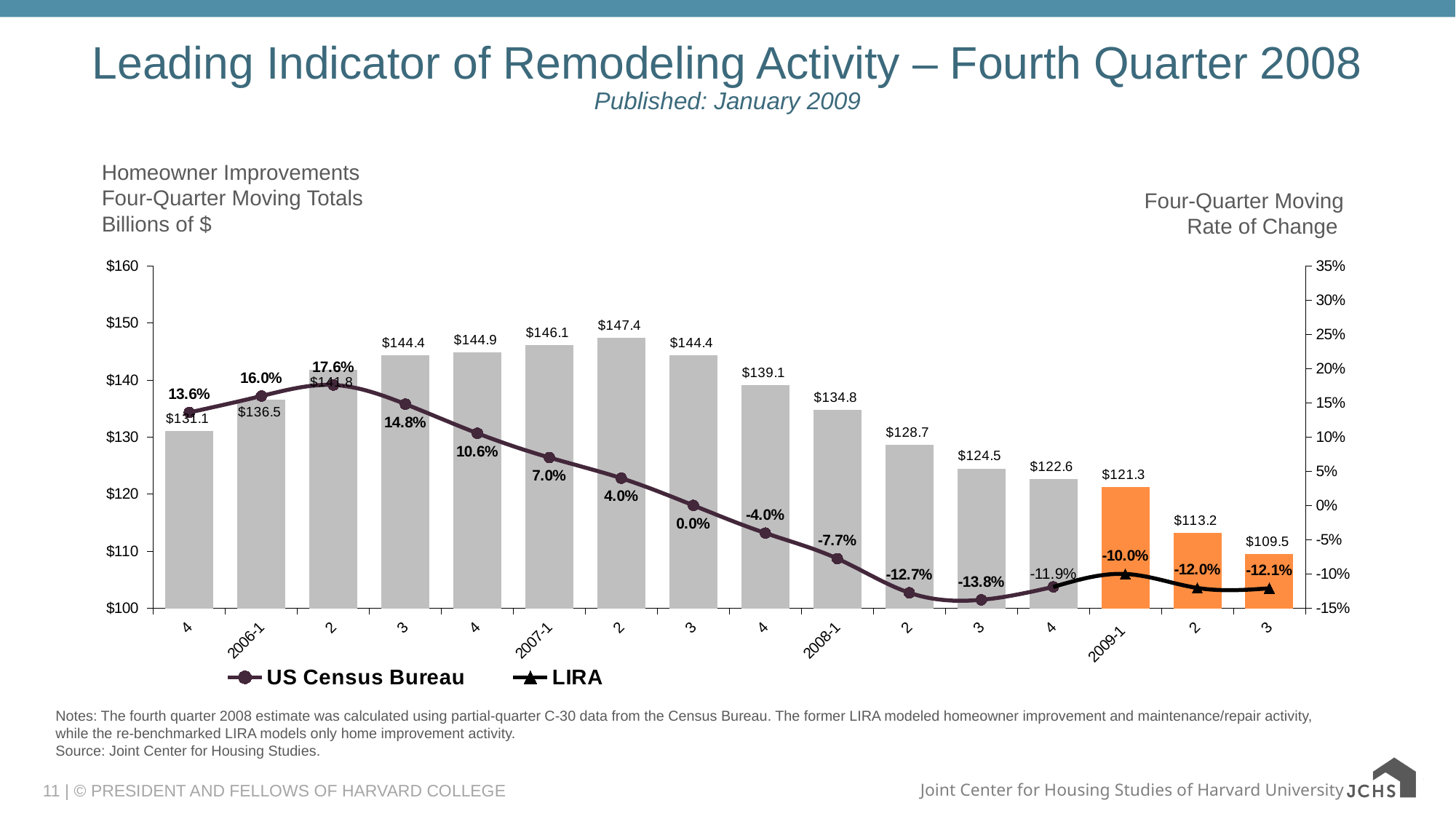
Which is larger, the four-quarter moving total for 2006-3 or for 2008-1? 2006-3 Which quarter has the lowest four-quarter moving rate of change? 2008-3 What are the two series named in the legend? US Census Bureau and LIRA How many series does the legend list? 2 What is the four-quarter moving total of homeowner improvements for 2007-2? $147.4 Which quarter has the highest four-quarter moving total of homeowner improvements? 2007-2 What is the four-quarter moving rate of change shown for 2008-1? -7.7% What is the difference between the four-quarter moving totals for 2007-2 and 2009-3? $37.9 Do the four-quarter moving totals rise or fall from 2007-2 to 2009-3? Fall What is the projected four-quarter moving total for 2009-3? $109.5 What kind of chart is used to show the four-quarter moving totals? Bar chart How many quarters (bars) are plotted on the chart? 16